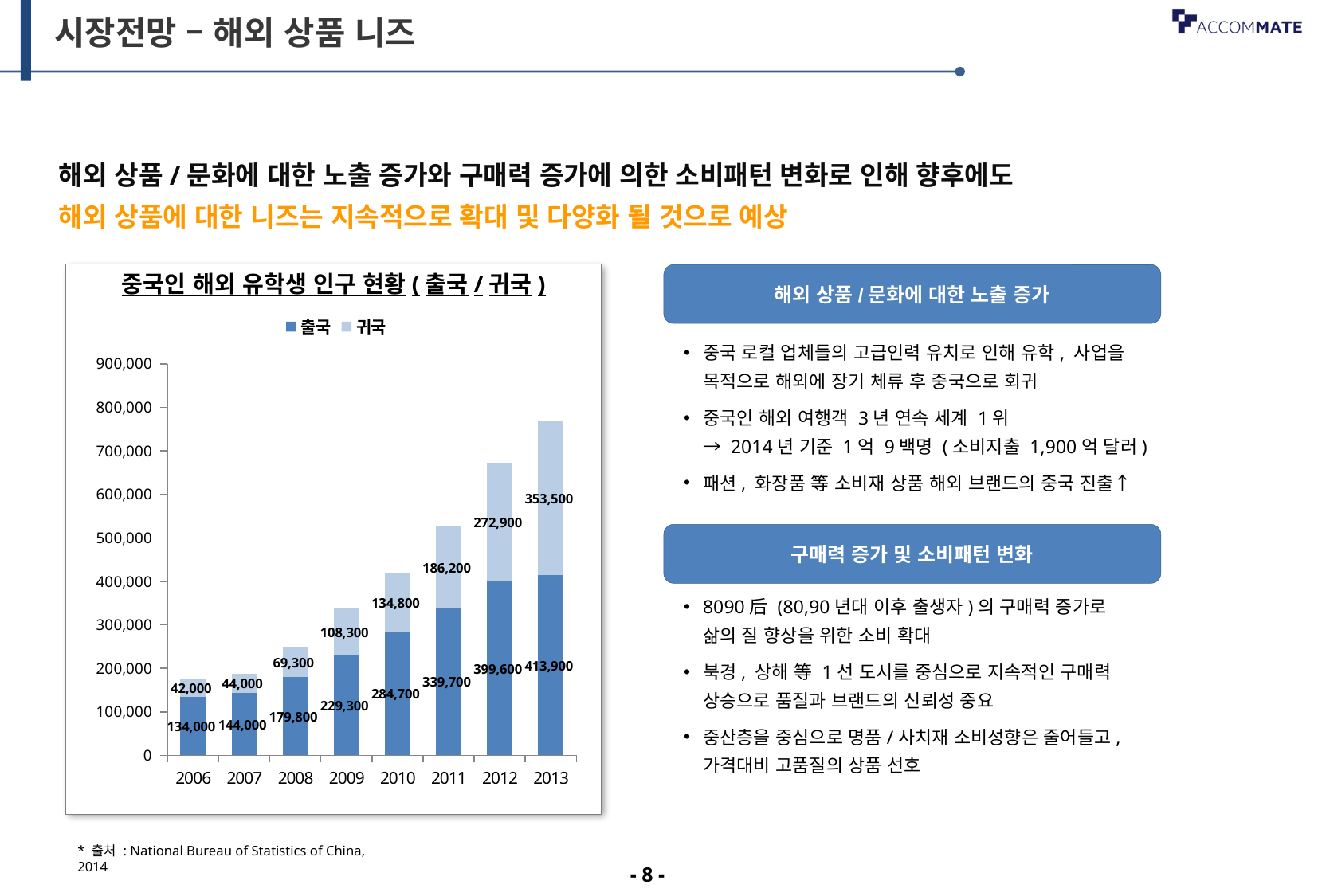
Do the 출국 values rise or fall from 2006 to 2013? rise What type of chart is shown on the slide? stacked bar chart What is the total of the stacked bar for 2013? 767,400 What is the difference between the 출국 value for 2013 and the 출국 value for 2012? 14,300 What is the 출국 value for 2010? 284,700 Which is larger, the 귀국 value for 2011 or the 출국 value for 2008? 귀국 value for 2011 Which year has the highest 귀국 value? 2013 How many years are shown on the x axis of the chart? 8 How many series does the chart legend list? 2 What is the 출국 value for 2006? 134,000 What is the 귀국 value for 2012? 272,900 Which year has the lowest 출국 value? 2006